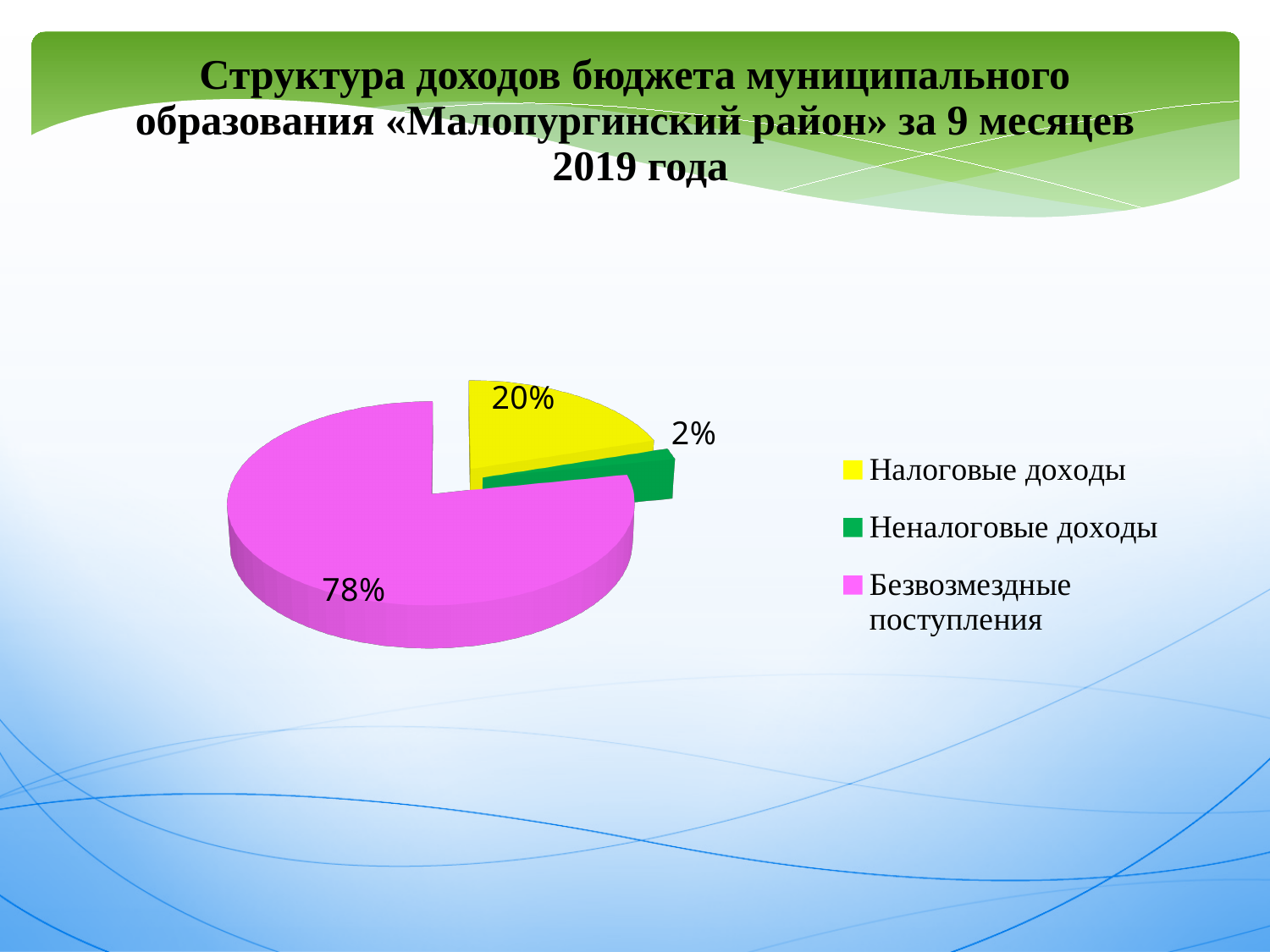
What is the difference between Безвозмездные поступления and Налоговые доходы? 58% What is the value for Неналоговые доходы? 2% What kind of chart is shown on the slide? pie chart What share of the pie is Безвозмездные поступления? 78% Which category has the smallest slice? Неналоговые доходы Which is larger, Налоговые доходы or Неналоговые доходы? Налоговые доходы How many slices does the pie chart have? 3 What is the value for Налоговые доходы? 20% What is the difference between Налоговые доходы and Неналоговые доходы? 18% Which category has the largest slice? Безвозмездные поступления What colour is the slice for Безвозмездные поступления? pink How many entries does the legend list? 3